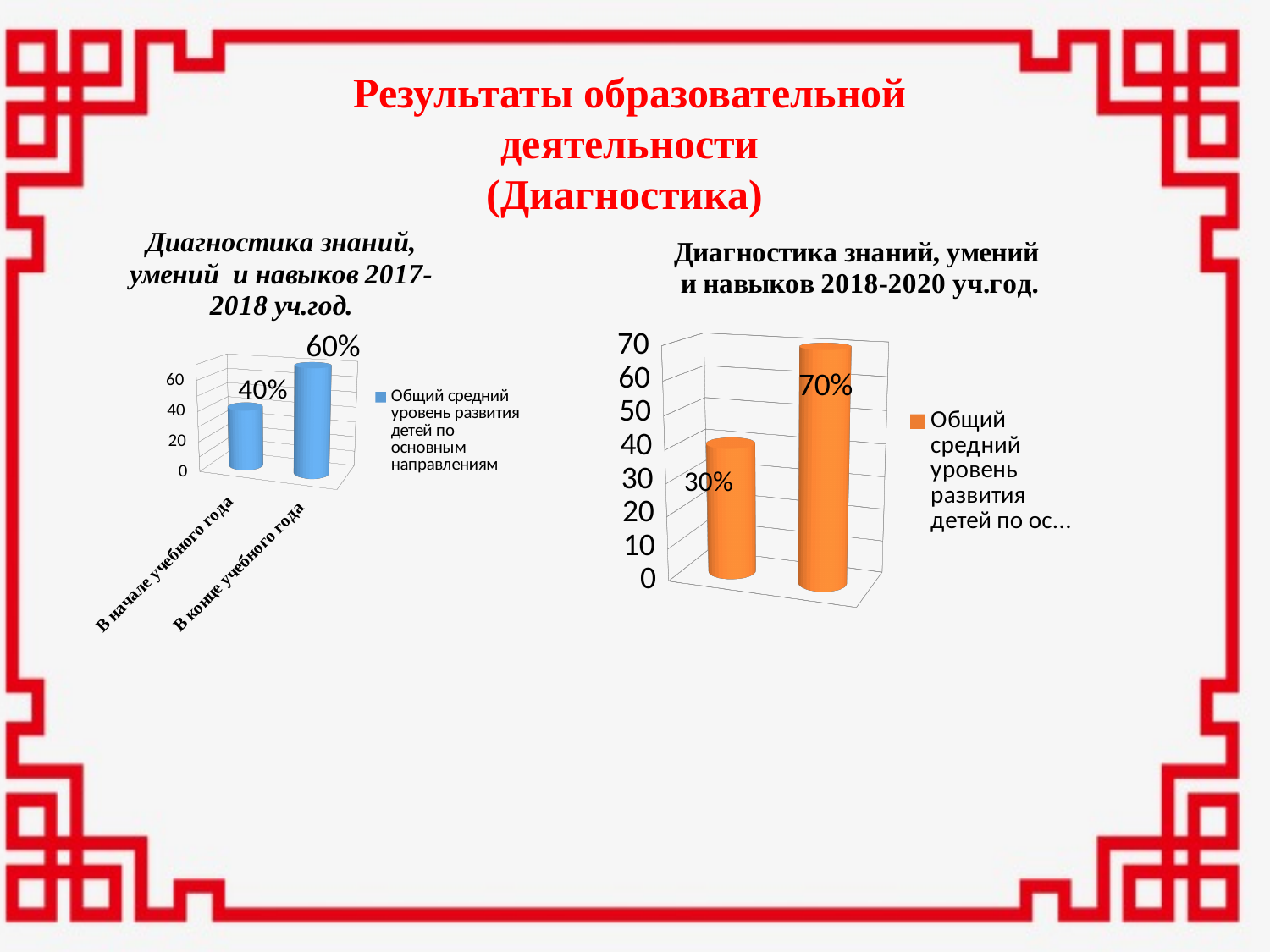
In the right chart (2018-2020 уч.год.), what is the value of the second (right) bar? 70% In the right chart (2018-2020 уч.год.), what is the difference between the two bars? 40% What colour are the bars in the right chart (2018-2020 уч.год.)? orange In the left chart (2017-2018 уч.год.), what is the value for 'В начале учебного года'? 40% What kind of chart is the right chart (2018-2020 уч.год.)? bar chart In the left chart (2017-2018 уч.год.), what is the difference between the values for 'В конце учебного года' and 'В начале учебного года'? 20% In the left chart (2017-2018 уч.год.), which category has the lowest value? В начале учебного года In the left chart (2017-2018 уч.год.), what is the value for 'В конце учебного года'? 60% In the left chart (2017-2018 уч.год.), how many categories are plotted? 2 In the right chart (2018-2020 уч.год.), do the values rise or fall from left to right? rise In the left chart (2017-2018 уч.год.), which category has the highest value? В конце учебного года In the right chart (2018-2020 уч.год.), what is the value of the first (left) bar? 30%